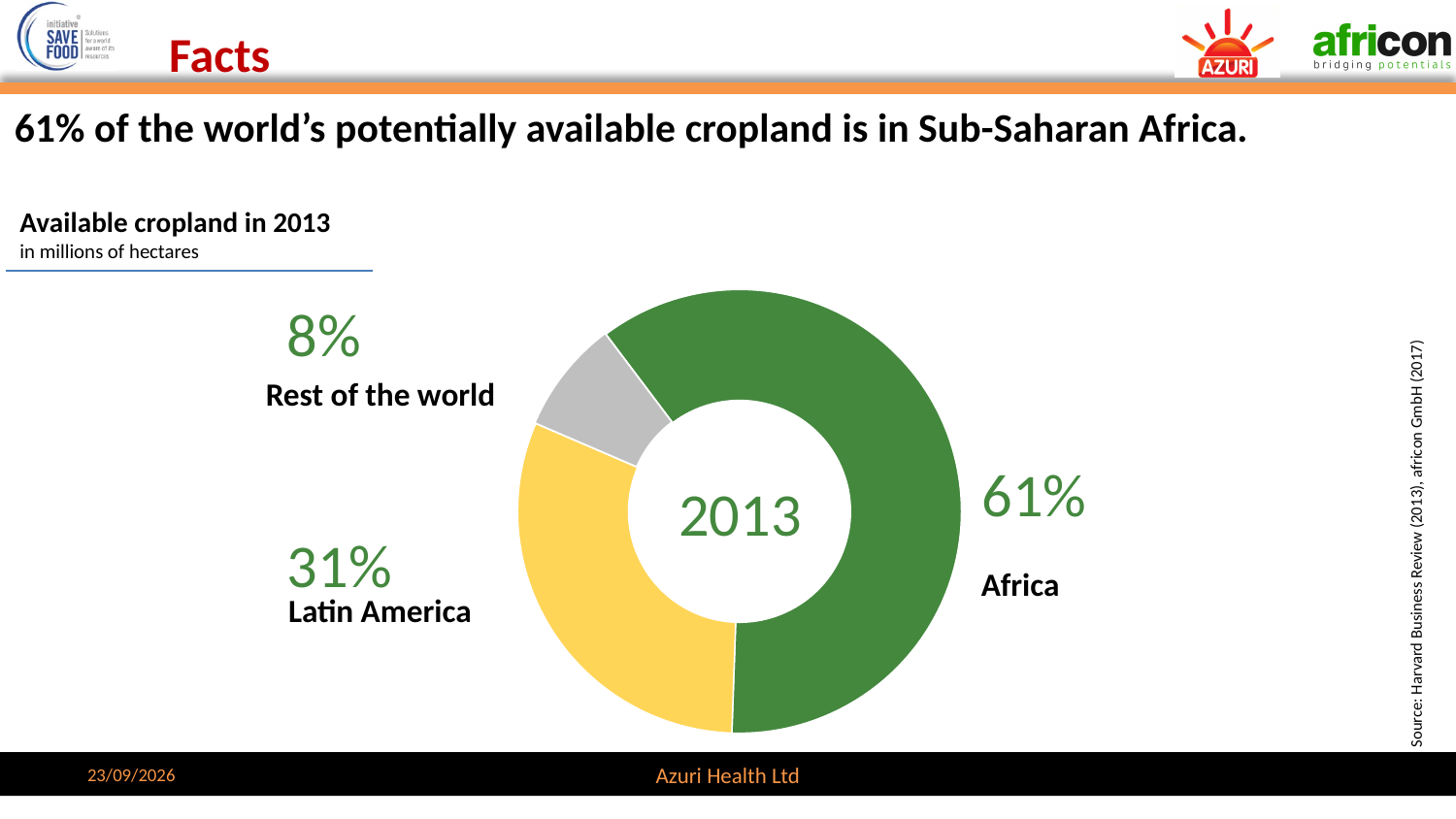
What is the title of the chart? Available cropland in 2013 What kind of chart is shown on the slide? Doughnut (pie) chart What share of available cropland in 2013 is in the Rest of the world? 8% What share of available cropland in 2013 is in Latin America? 31% What share of available cropland in 2013 is in Africa? 61% Which region has the largest share of available cropland in 2013? Africa What is the difference in percentage points between Africa's share and Latin America's share? 30 percentage points Which region has the smallest share of available cropland in 2013? Rest of the world How many regions are shown in the chart? 3 What year is shown in the centre of the doughnut chart? 2013 Which has a larger share of available cropland, Latin America or the Rest of the world? Latin America What is the combined share of Africa and Latin America? 92%